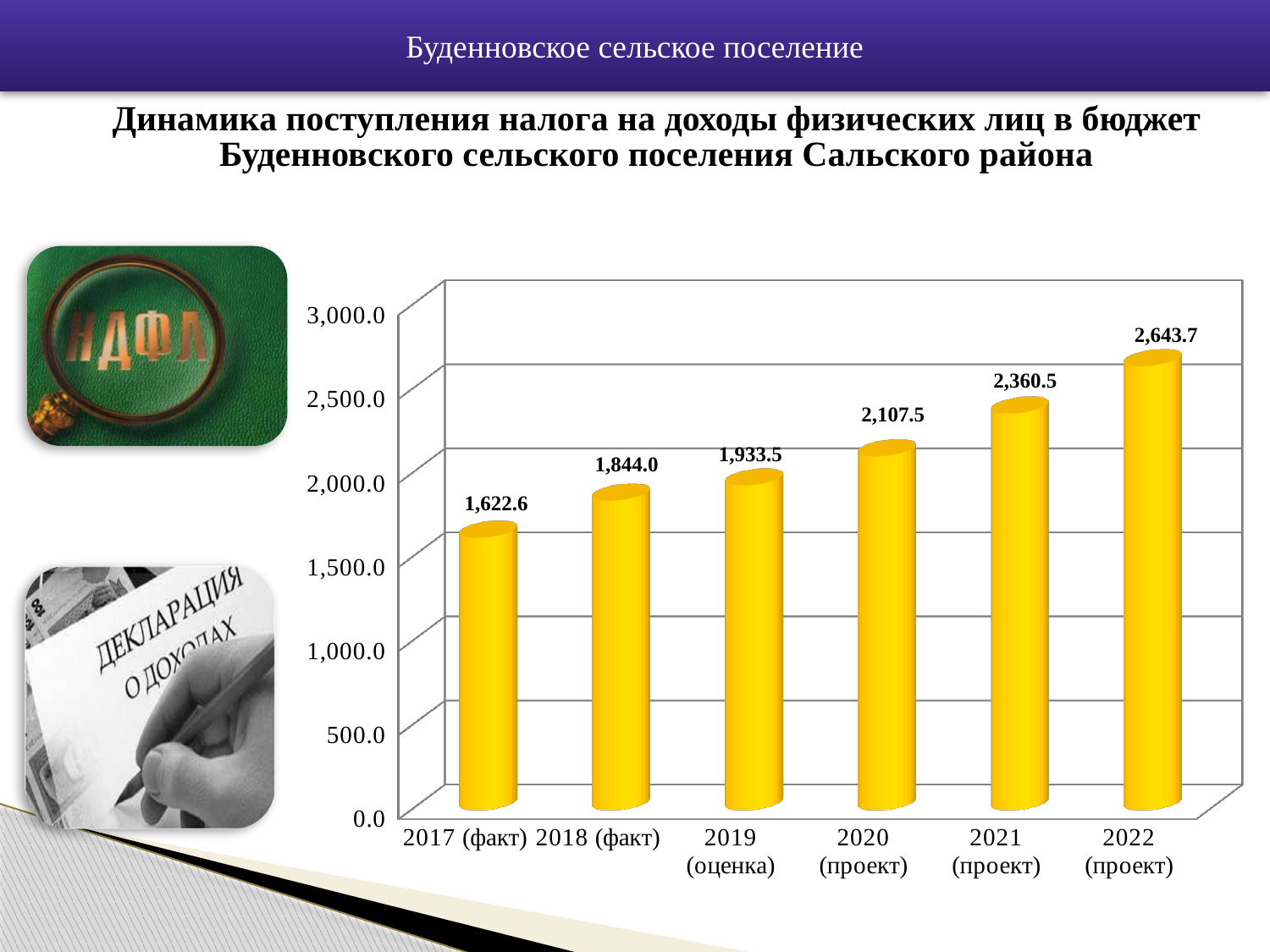
What is the value for 2017 (факт)? 1,622.6 How many years are shown on the x axis? 6 What kind of chart is shown on the slide? bar chart Do the values rise or fall from 2017 to 2022? rise Which year has the highest value? 2022 (проект) What is the difference between the values for 2018 (факт) and 2017 (факт)? 221.4 What is the value for 2020 (проект)? 2,107.5 Is the value for 2021 (проект) greater or less than 2,500.0? less What is the difference between the values for 2022 (проект) and 2021 (проект)? 283.2 Which year has the lowest value? 2017 (факт) Which is larger, the value for 2019 (оценка) or the value for 2020 (проект)? 2020 (проект) What is the value for 2022 (проект)? 2,643.7